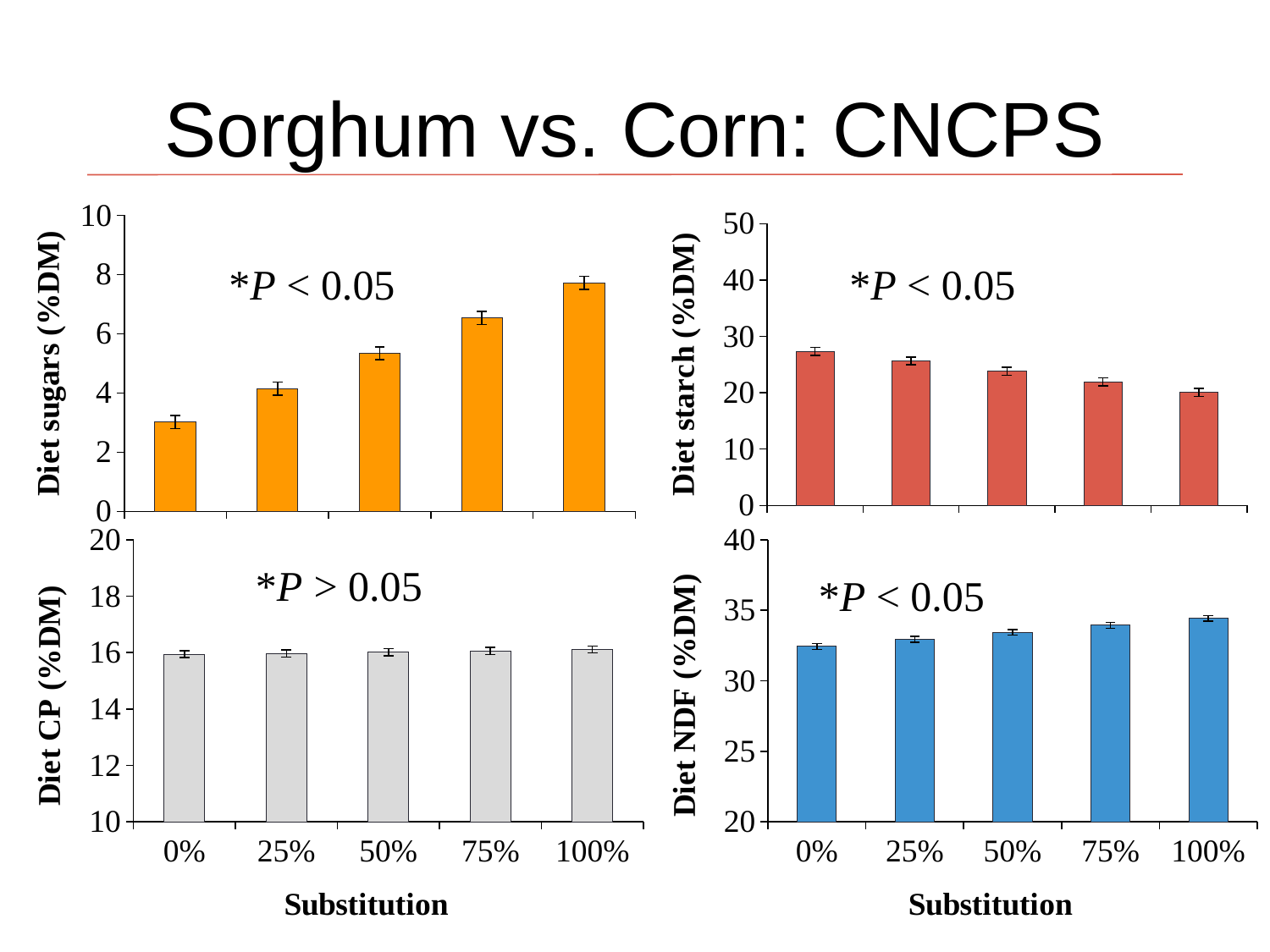
In the Diet starch chart, is the value for 100% substitution greater or less than 30? less In the Diet starch chart, which is larger, the value for 0% or the value for 75% substitution? 0% In the Diet sugars chart, which substitution level has the highest value? 100% In the Diet starch chart, which substitution level has the highest value? 0% In the Diet sugars chart, do the values rise or fall as substitution increases from 0% to 100%? rise In the Diet NDF chart, which substitution level has the highest value? 100% In the Diet sugars chart, which substitution level has the lowest value? 0% In the Diet sugars chart, is the value for 100% substitution greater or less than 6? greater What kind of chart is the Diet NDF chart? bar chart How many substitution levels are shown in the Diet CP chart? 5 In the Diet CP chart, is the value for 0% substitution greater or less than 18? less In the Diet starch chart, do the values rise or fall as substitution increases from 0% to 100%? fall